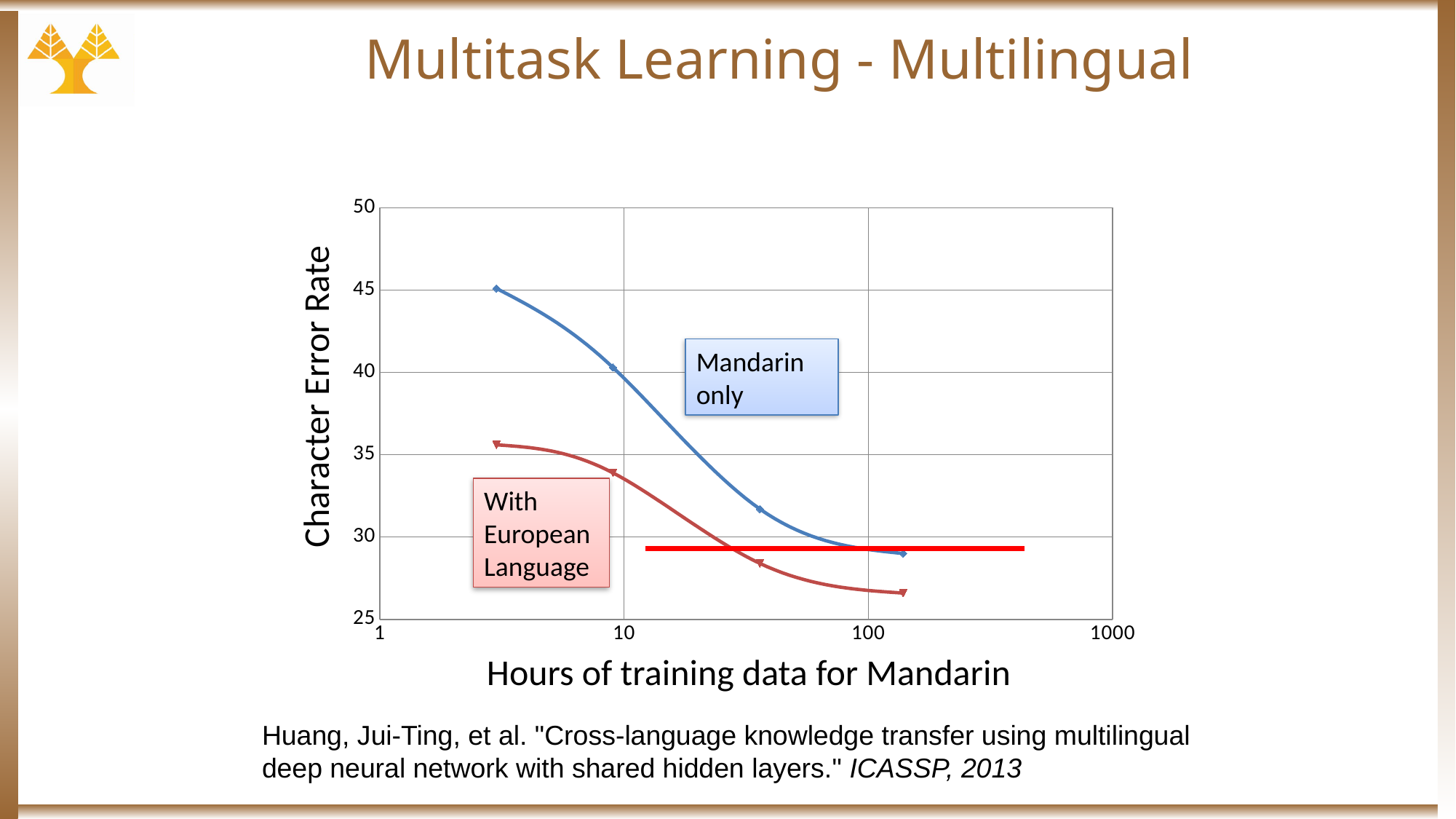
Which series has the lower Character Error Rate across all amounts of training data? With European Language Is the Character Error Rate for With European Language at its rightmost point greater or less than 30? less At the smallest amount of training data, which series has the higher Character Error Rate, Mandarin only or With European Language? Mandarin only Is the Character Error Rate for Mandarin only at its rightmost point greater or less than 35? less What is the title of the x axis of the chart? Hours of training data for Mandarin How many data points does the Mandarin only series have? 4 How many data series are plotted on the chart? 2 Does the Character Error Rate for With European Language rise or fall as the hours of training data increase? fall Does the Character Error Rate for Mandarin only rise or fall as the hours of training data increase? fall What kind of chart is shown on the slide? line chart Is the Character Error Rate for Mandarin only at its leftmost point greater or less than 40? greater